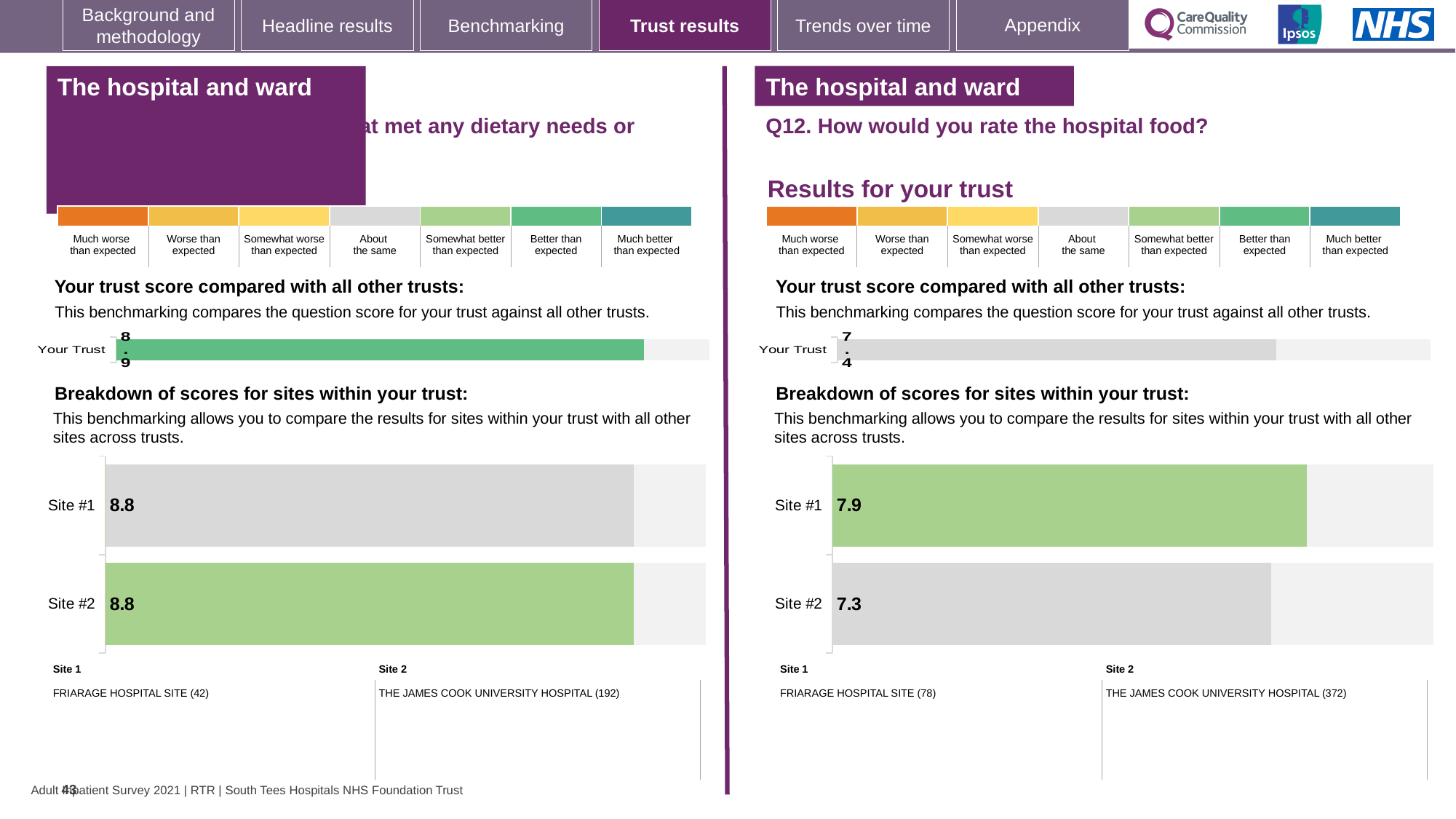
In the site breakdown chart on the left-hand side of the slide, what colour is the bar for Site #1? grey In the Q12 site breakdown chart on the right, what is the score for Site #1? 7.9 How many sites are shown in the site breakdown chart on the right-hand side of the slide? 2 In the Q12 site breakdown chart on the right, which site has the higher score? Site #1 In the site breakdown chart on the left-hand side of the slide, what is the score for Site #1? 8.8 What type of chart is used for the site breakdown on the right-hand side of the slide? bar chart In the Q12 site breakdown chart on the right, is the score for Site #1 larger or smaller than the score for Site #2? larger On the right-hand side of the slide (Q12, hospital food), what is the score shown for Your Trust? 7.4 In the Q12 site breakdown chart on the right, what is the difference between the Site #1 and Site #2 scores? 0.6 In the Q12 site breakdown chart on the right, what colour is the bar for Site #1? green In the Q12 site breakdown chart on the right, what is the score for Site #2? 7.3 On the left-hand side of the slide, what is the score shown for Your Trust? 8.9